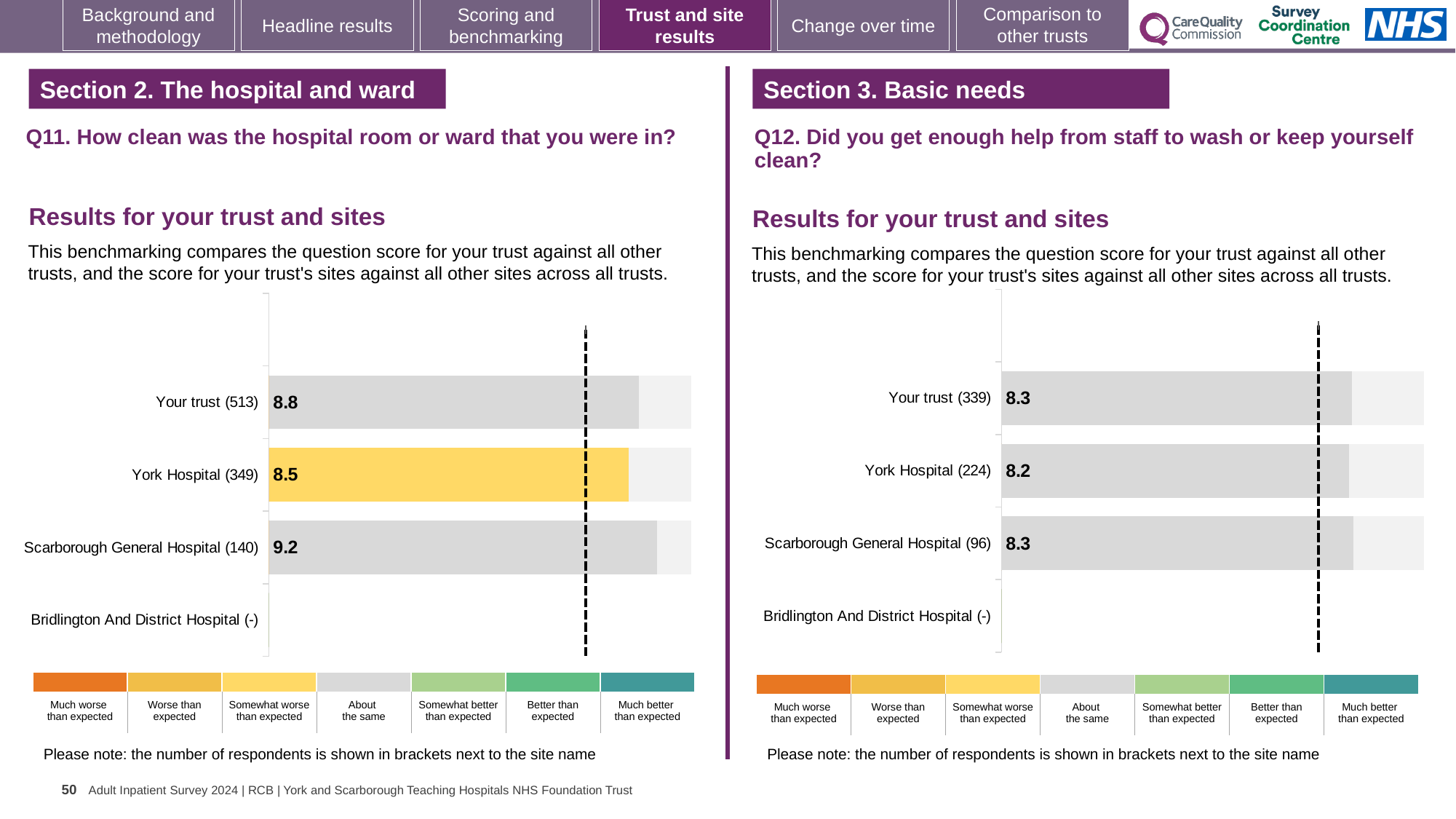
In the Q12 chart on the right, what is the score for Scarborough General Hospital? 8.3 In the Q11 chart on the left, how many respondents are shown in brackets for York Hospital? 349 In the Q12 chart on the right, what is the difference between the scores for Your trust and York Hospital? 0.1 In the Q11 chart on the left, which site's bar is coloured yellow? York Hospital In the Q11 chart on the left, what is the score for Your trust? 8.8 In the Q11 chart on the left, which is larger: the score for Your trust or the score for York Hospital? Your trust In the Q11 chart on the left, what is the difference between the scores for Scarborough General Hospital and York Hospital? 0.7 In the Q11 chart on the left, which site has the highest score? Scarborough General Hospital In the Q11 chart on the left, what is the score for Scarborough General Hospital? 9.2 In the Q12 chart on the right, how many respondents are shown in brackets for Your trust? 339 In the Q12 chart on the right, what is the score for York Hospital? 8.2 What kind of chart is used in the Q11 chart on the left? Bar chart